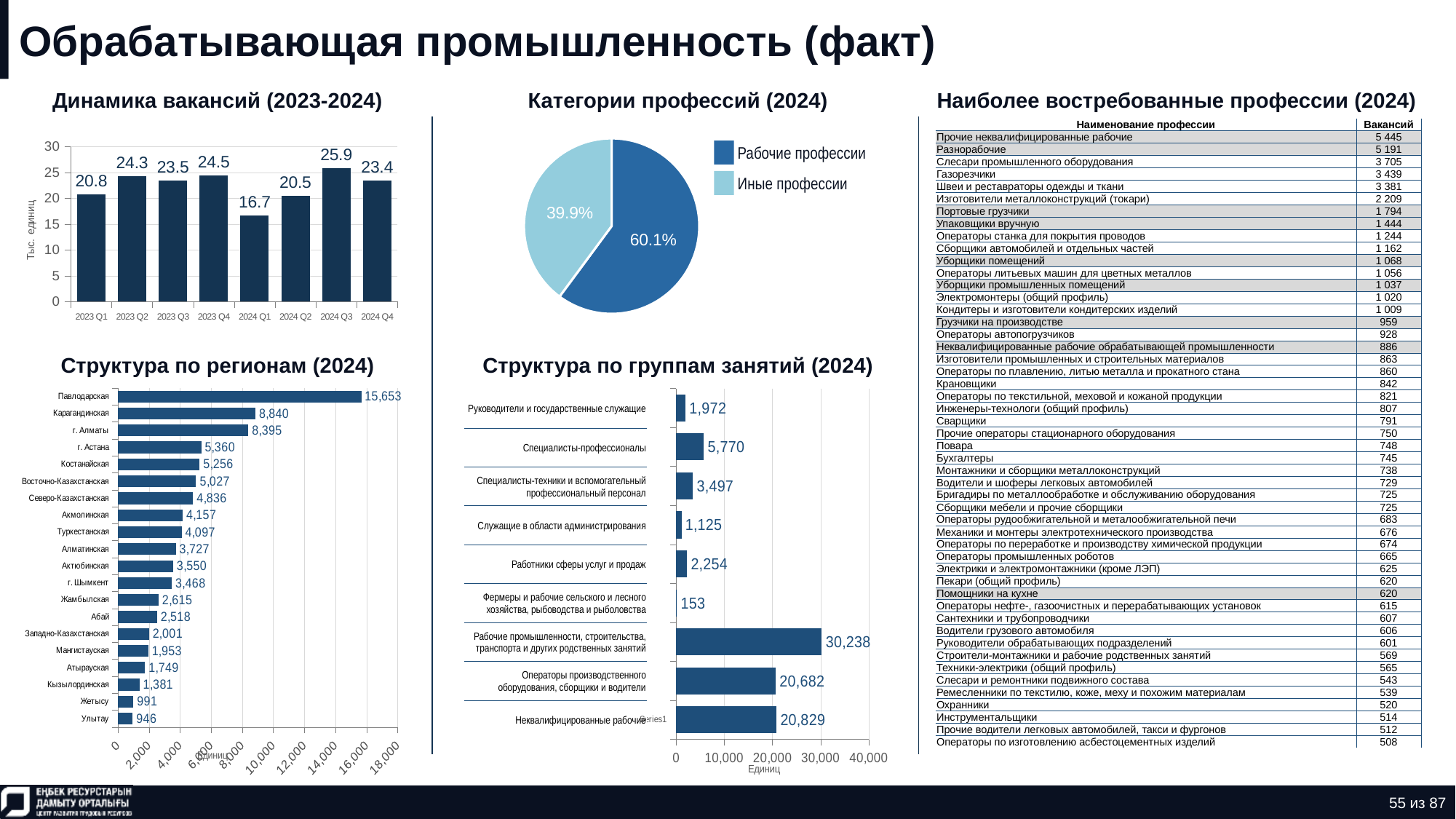
In the chart 'Категории профессий (2024)', what share of the pie is 'Рабочие профессии'? 60.1% In the chart 'Категории профессий (2024)', how many entries does the legend list? 2 In the chart 'Структура по группам занятий (2024)', what is the value for 'Специалисты-профессионалы'? 5,770 In the chart 'Структура по регионам (2024)', what is the value for Карагандинская? 8,840 In the chart 'Динамика вакансий (2023-2024)', what is the value for 2024 Q1? 16.7 In the chart 'Структура по регионам (2024)', which region has the lowest value? Улытау In the chart 'Динамика вакансий (2023-2024)', how many quarters are plotted? 8 In the chart 'Структура по группам занятий (2024)', which group has the highest value? Рабочие промышленности, строительства, транспорта и других родственных занятий In the chart 'Структура по регионам (2024)', which is larger: г. Астана or Костанайская? г. Астана What kind of chart is 'Категории профессий (2024)'? Pie chart In the chart 'Динамика вакансий (2023-2024)', what is the difference between 2024 Q3 and 2024 Q1? 9.2 In the chart 'Динамика вакансий (2023-2024)', which quarter has the highest value? 2024 Q3